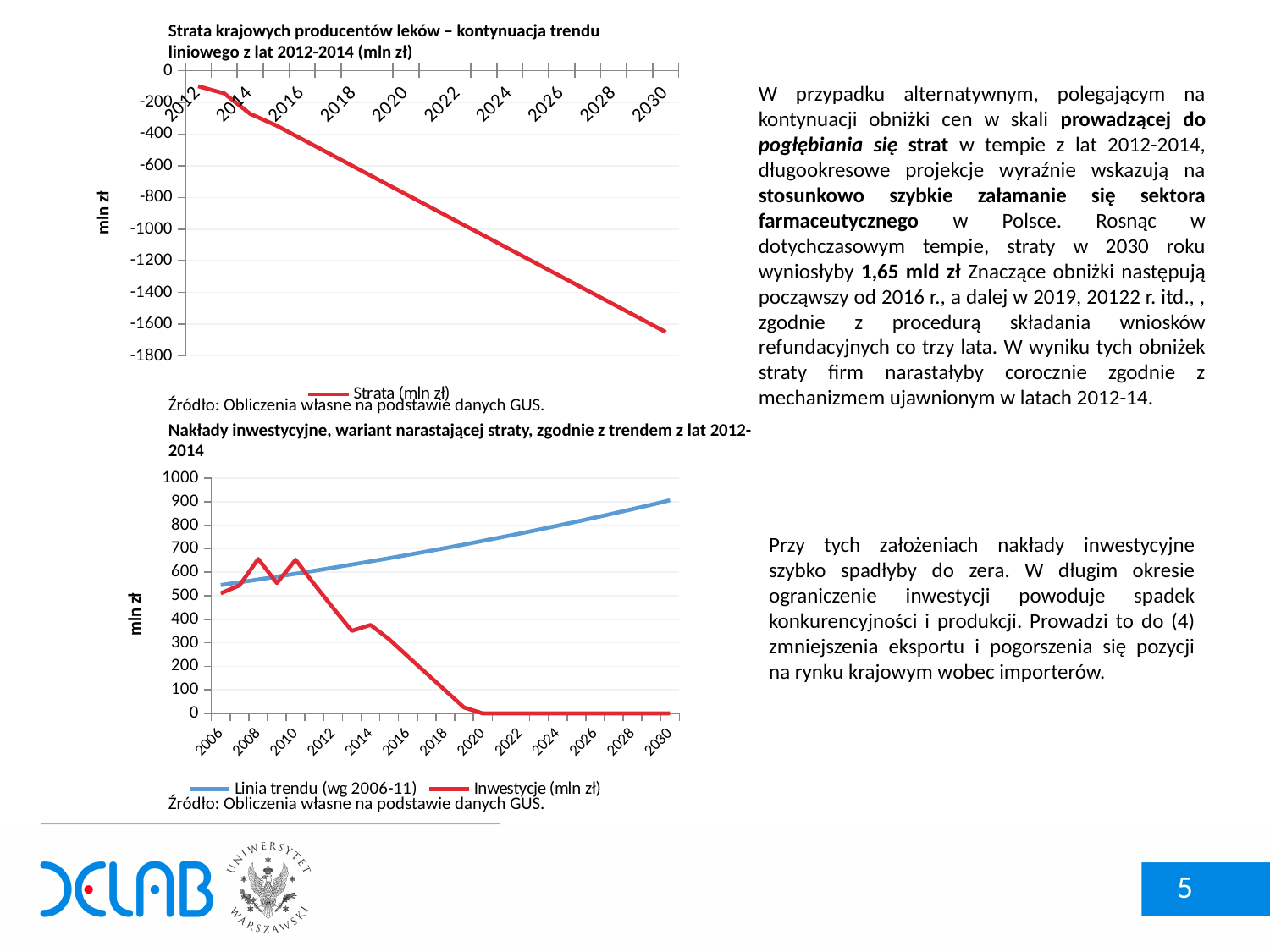
In the top chart 'Strata krajowych producentów leków', do the values rise or fall from 2012 to 2030? fall What kind of chart is the top chart titled 'Strata krajowych producentów leków'? line chart In the bottom chart 'Nakłady inwestycyjne', how many series does the legend list? 2 In the bottom chart 'Nakłady inwestycyjne', is the value of 'Linia trendu (wg 2006-11)' in 2030 greater or less than 800? greater What is the y-axis label of the top chart 'Strata krajowych producentów leków'? mln zł In the bottom chart 'Nakłady inwestycyjne', what is the value of 'Inwestycje (mln zł)' in 2030? 0 In the top chart 'Strata krajowych producentów leków', how many series does the legend list? 1 In the top chart 'Strata krajowych producentów leków', is the value for 2014 greater or less than -400? greater In the bottom chart 'Nakłady inwestycyjne', does the 'Linia trendu (wg 2006-11)' series rise or fall from 2006 to 2030? rise In the bottom chart 'Nakłady inwestycyjne', which series has the higher value in 2020: 'Linia trendu (wg 2006-11)' or 'Inwestycje (mln zł)'? Linia trendu (wg 2006-11) What kind of chart is the bottom chart titled 'Nakłady inwestycyjne, wariant narastającej straty'? line chart